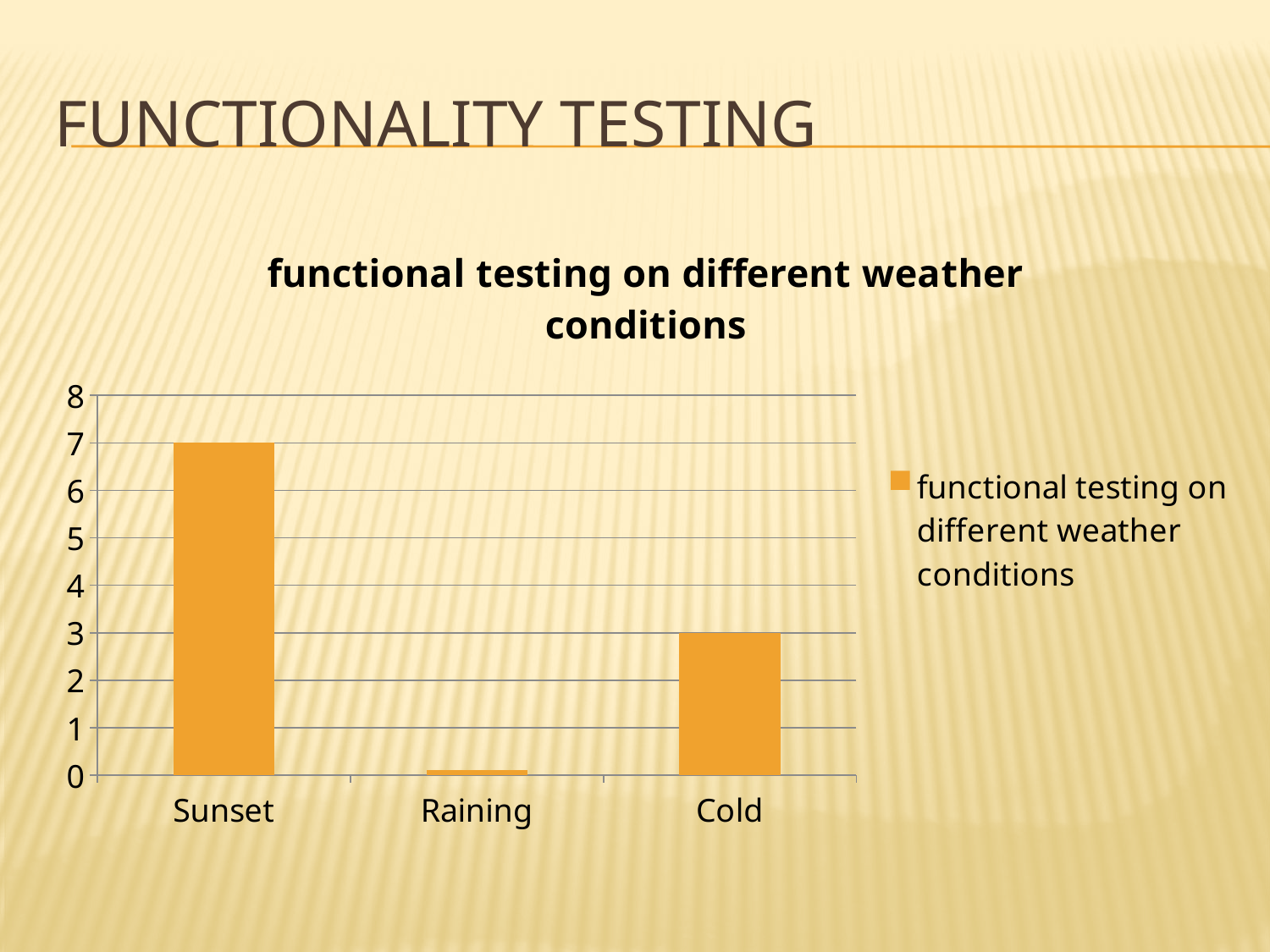
Is the value for Cold greater or less than 5? less What is the difference between the values for Sunset and Cold? 4 How many weather conditions are shown on the x axis? 3 Which weather condition has the lowest value? Raining How many series does the legend list? 1 What is the value for Cold? 3 Which weather condition has the highest value? Sunset Which is larger, the value for Sunset or the value for Cold? Sunset What is the value for Sunset? 7 What is the title of the chart? functional testing on different weather conditions What kind of chart is shown on the slide? bar chart Is the value for Raining greater or less than 1? less